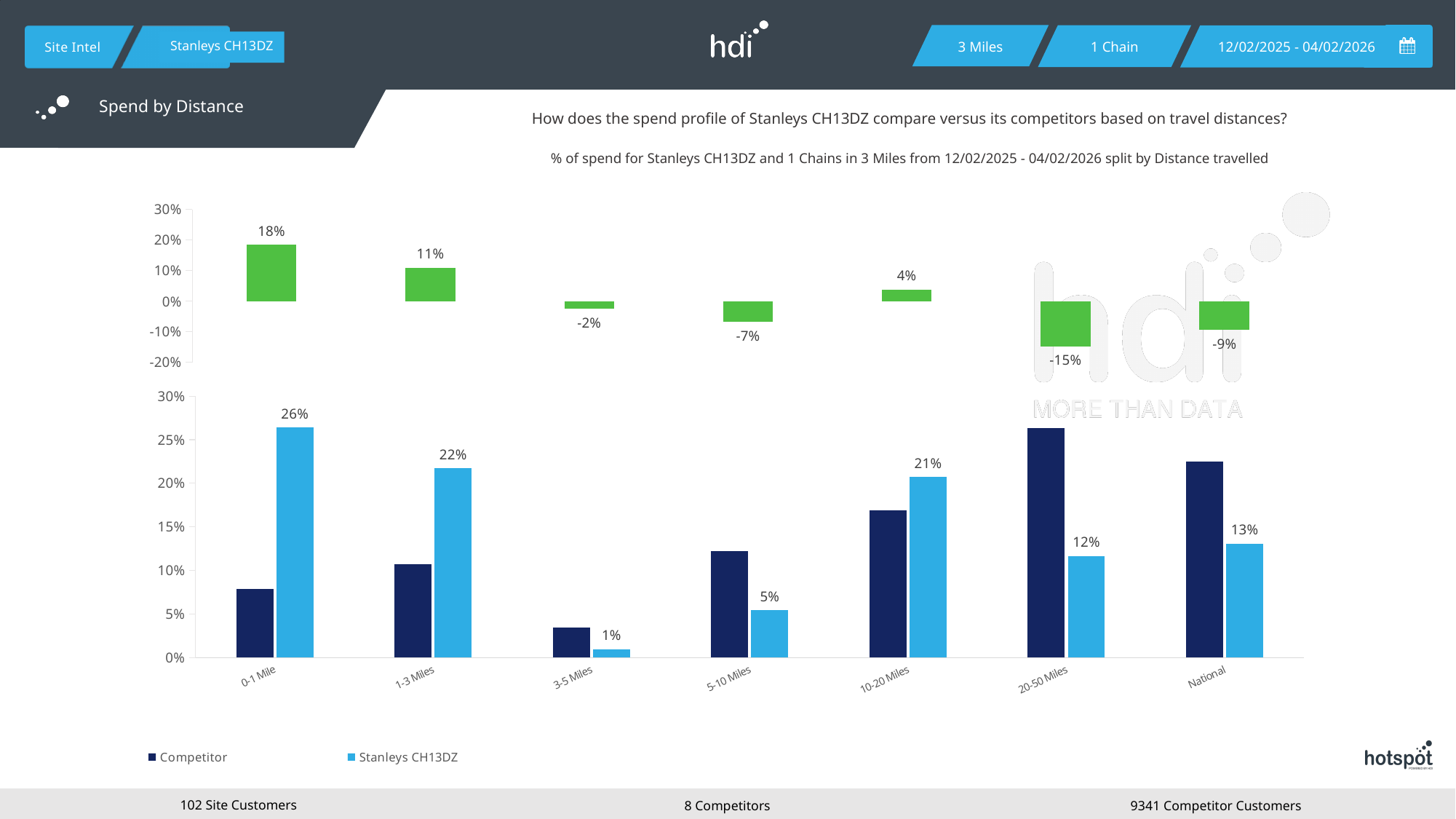
In the bottom chart, which category has the highest value for Stanleys CH13DZ? 0-1 Mile In the bottom chart, what is the difference between the Stanleys CH13DZ values for 0-1 Mile and National? 13% How many series does the legend of the bottom chart list? 2 In the bottom chart, is the Competitor value for 20-50 Miles greater or less than 25%? greater In the top chart, what is the value shown for the 1-3 Miles category? 11% In the bottom chart, which is larger in the 20-50 Miles category, Competitor or Stanleys CH13DZ? Competitor In the top chart, which category has the lowest value? 20-50 Miles In the bottom chart, what is the value for Stanleys CH13DZ in the 10-20 Miles category? 21% In the bottom chart, which category has the lowest value for Stanleys CH13DZ? 3-5 Miles In the bottom chart, what is the value for Stanleys CH13DZ in the 0-1 Mile category? 26% How many categories are shown on the x axis of the bottom chart? 7 In the top chart, what is the value shown for the 20-50 Miles category? -15%